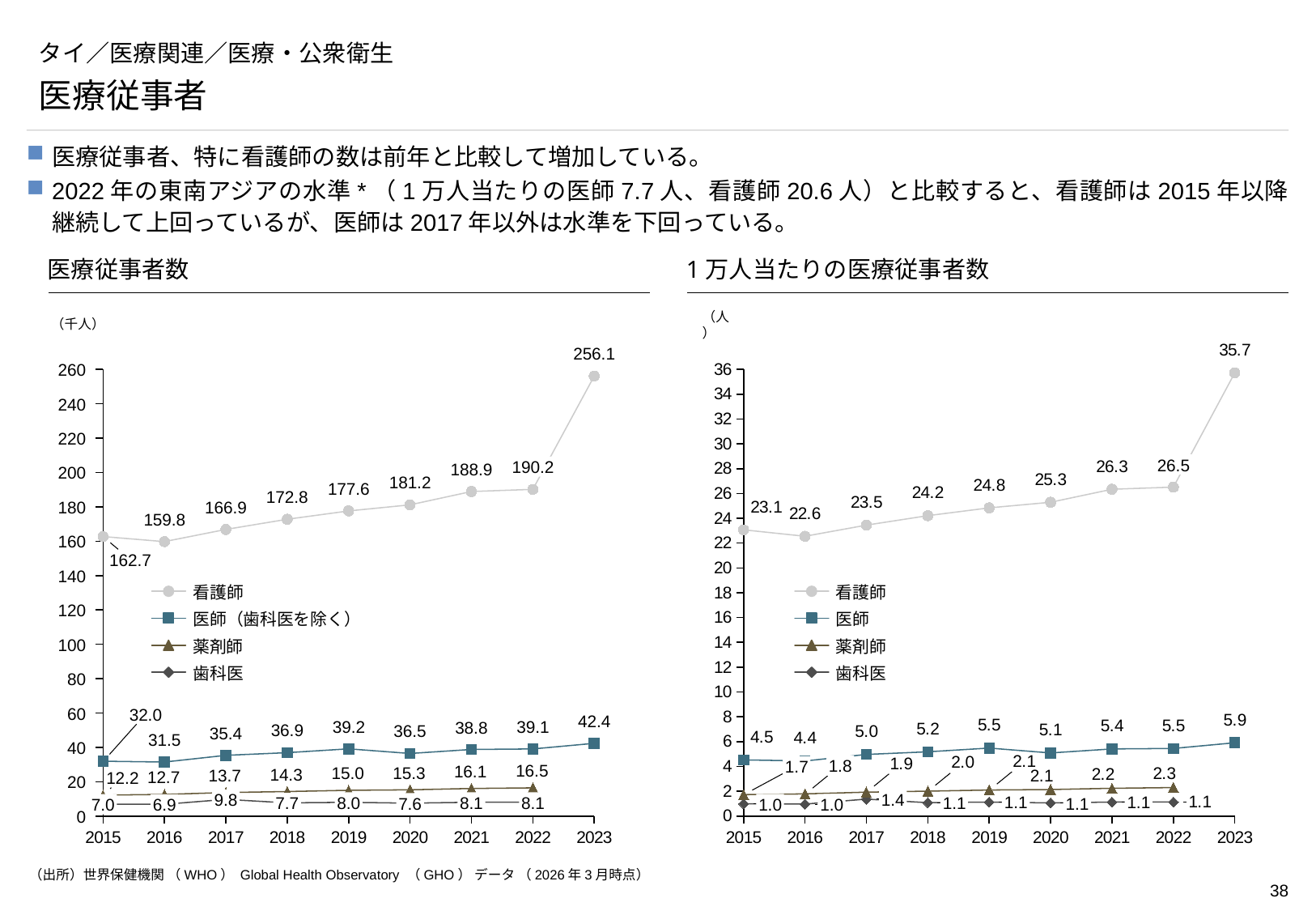
「医療従事者数」のグラフで、2023年の看護師の値はいくつですか。 256.1 「1万人当たりの医療従事者数」のグラフで、2017年の歯科医の値は2018年の値より大きいですか、小さいですか。 大きい 「医療従事者数」のグラフで、2019年の医師（歯科医を除く）の値はいくつですか。 39.2 「医療従事者数」のグラフは、どの種類のグラフですか。 折れ線グラフ 「医療従事者数」のグラフで、看護師の値が最も低いのは何年ですか。 2016 「1万人当たりの医療従事者数」のグラフで、看護師の値が最も高いのは何年ですか。 2023 「1万人当たりの医療従事者数」のグラフで、2015年と2023年の看護師の値の差はいくつですか。 12.6 「医療従事者数」のグラフで、凡例にはいくつの系列がありますか。 4 「1万人当たりの医療従事者数」のグラフで、横軸には何年分のデータ点がありますか。 9 「1万人当たりの医療従事者数」のグラフで、2020年の看護師の値はいくつですか。 25.3 「医療従事者数」のグラフで、2022年と2023年の看護師の値の差はいくつですか。 65.9 「1万人当たりの医療従事者数」のグラフで、2023年の医師の値はいくつですか。 5.9